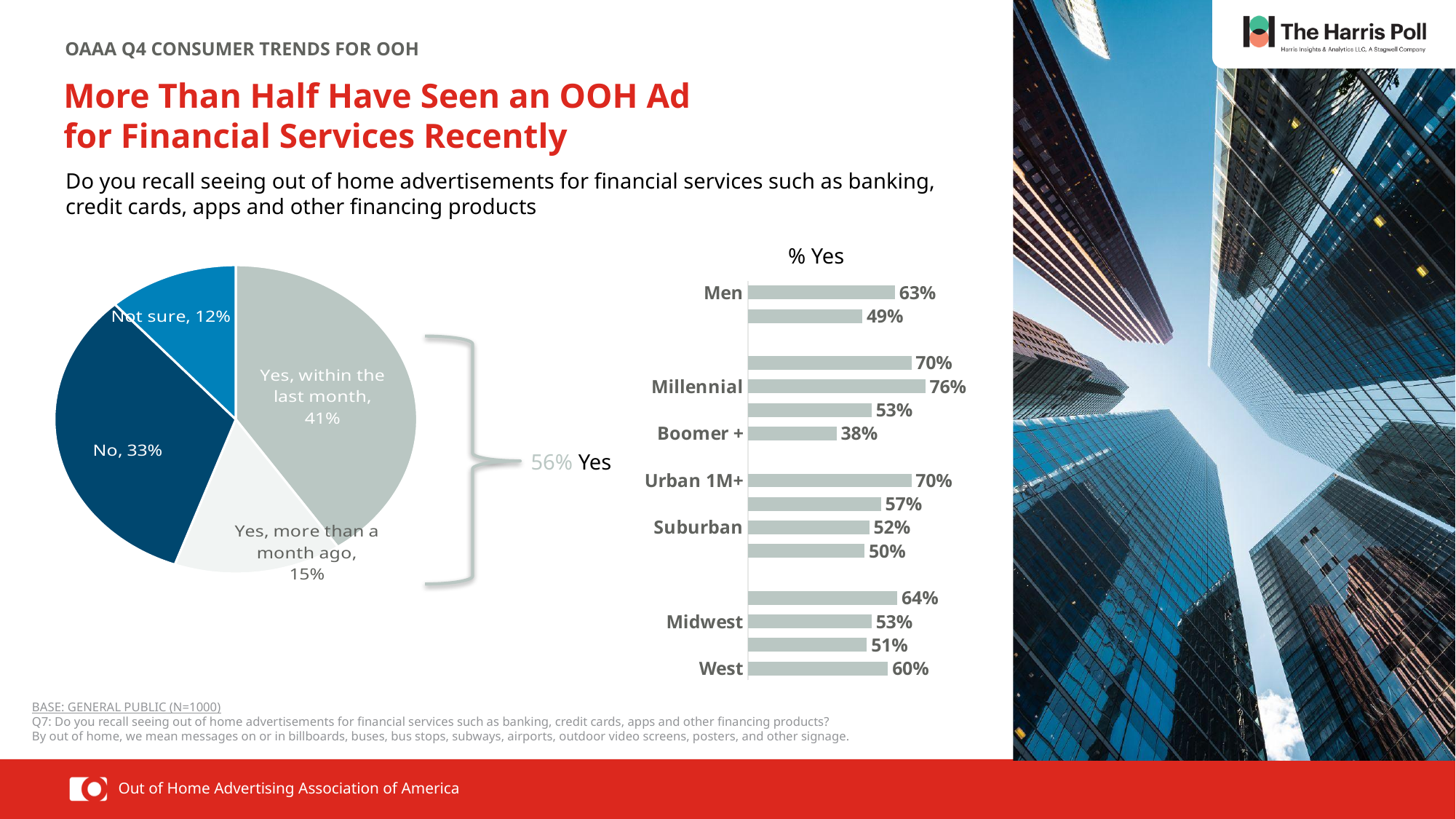
In the pie chart, which response has the smallest slice? Not sure In the '% Yes' bar chart, which is larger, the value for West or the value for Suburban? West In the pie chart, how many slices are there? 4 In the '% Yes' bar chart, what is the value for Boomer +? 38% In the '% Yes' bar chart, what is the value for Millennial? 76% In the pie chart, what share of respondents answered 'Not sure'? 12% According to the bracket next to the pie chart, what is the combined share of respondents who answered Yes? 56% Yes In the '% Yes' bar chart, what is the difference between the values for Men and Boomer +? 25% What type of chart is the '% Yes' chart on the right? Bar chart In the '% Yes' bar chart, what is the value for Urban 1M+? 70% In the pie chart, what share of respondents answered 'No'? 33% In the pie chart, what share of respondents said 'Yes, within the last month'? 41%